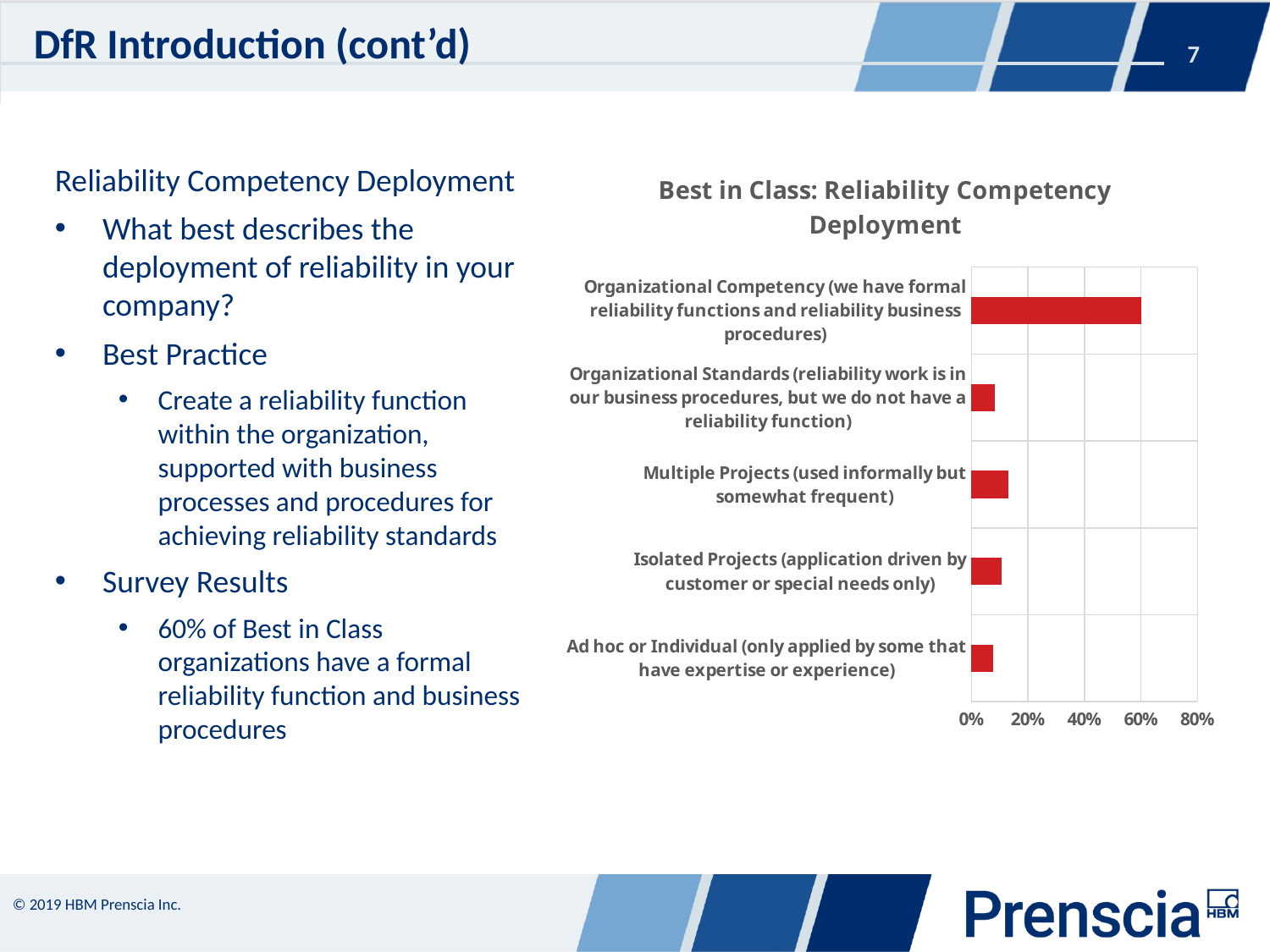
What type of chart is shown on the slide? Bar chart What is the title of the chart? Best in Class: Reliability Competency Deployment Which category has the highest value in the chart? Organizational Competency (we have formal reliability functions and reliability business procedures) Which is larger: the value for Multiple Projects or the value for Organizational Standards? Multiple Projects What is the value for Organizational Competency in the chart? 60% Is the value for Organizational Competency greater or less than 40%? greater What is the highest value shown on the chart's horizontal axis? 80% What colour are the bars in the chart? Red Is the value for Isolated Projects greater or less than 20%? less How many categories are plotted in the chart? 5 Which is larger: the value for Organizational Competency or the value for Multiple Projects? Organizational Competency Is the value for Multiple Projects greater or less than 20%? less